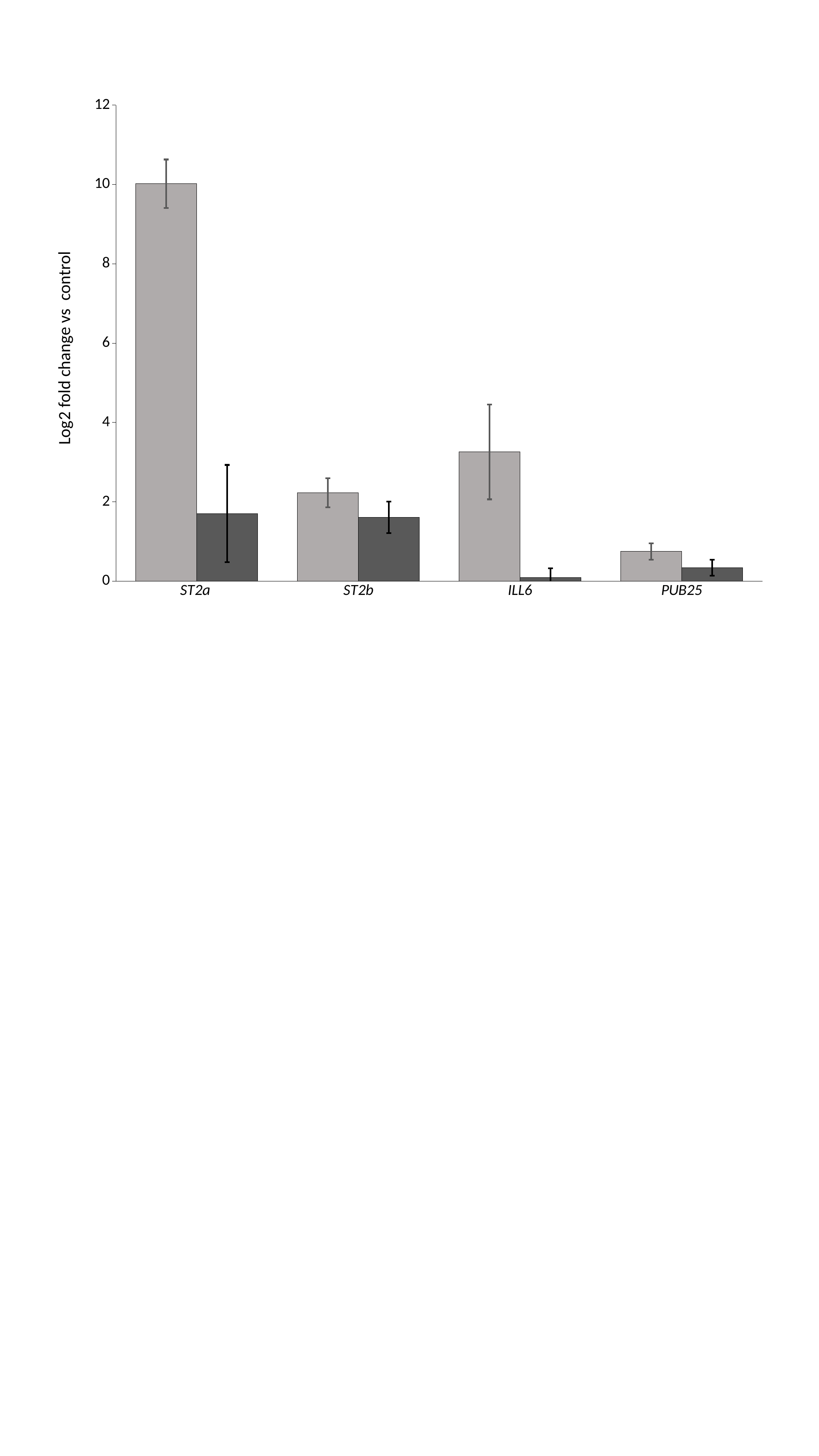
Is the light grey bar for ILL6 greater or less than 4? less What kind of chart is shown on the slide? bar chart How many bars are plotted for each category? 2 Which category has the highest light grey bar? ST2a Which category has the lowest light grey bar? PUB25 How many categories are shown on the x axis? 4 Which is larger, the light grey bar for ST2b or the light grey bar for ILL6? ILL6 What is the title of the y axis? Log2 fold change vs control Is the light grey bar for PUB25 greater or less than 2? less Which is larger, the dark grey bar for ST2a or the dark grey bar for ILL6? ST2a Is the light grey bar for ST2a greater or less than 8? greater Which category has the lowest dark grey bar? ILL6